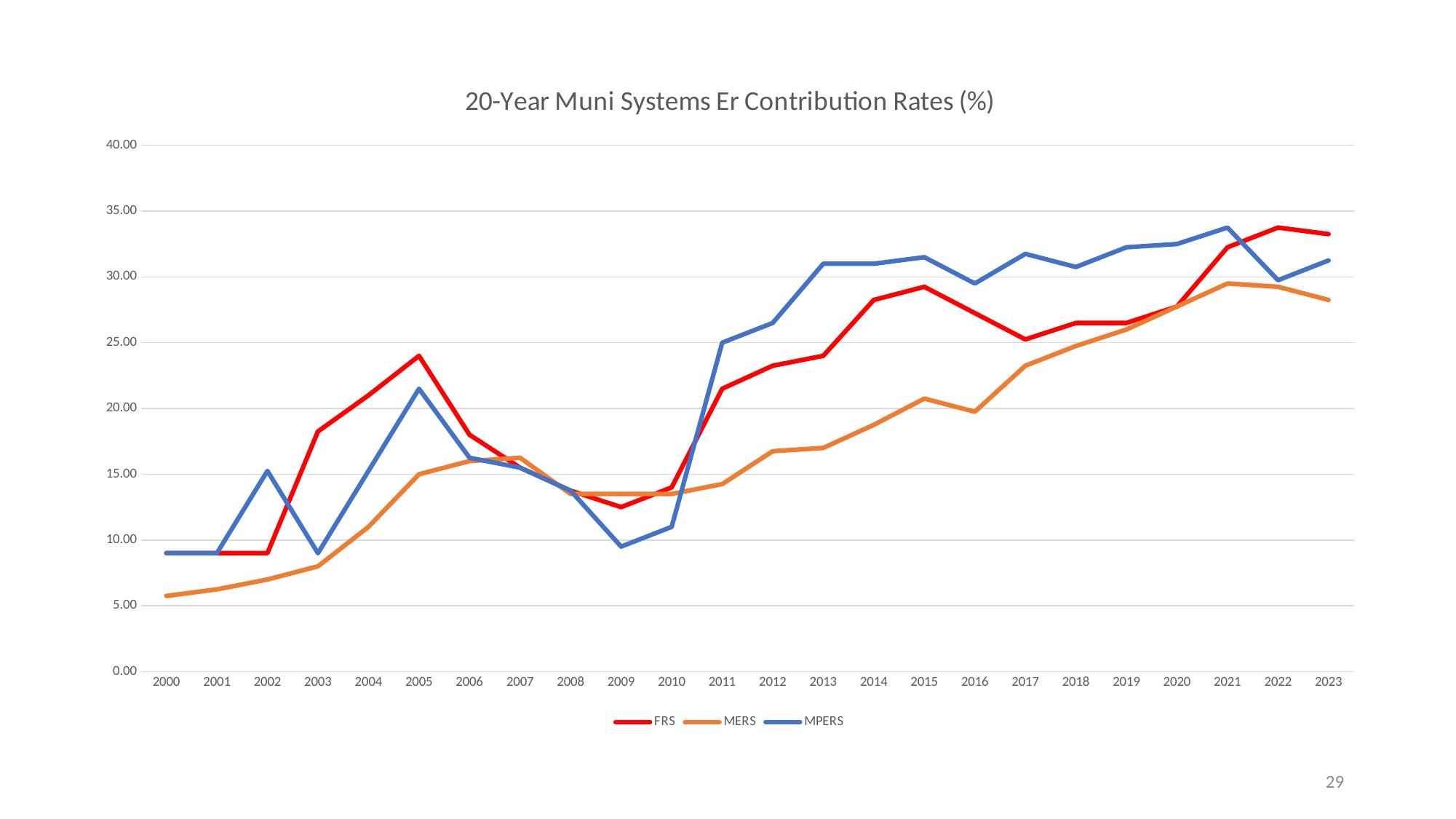
Is the value for MPERS in 2013 greater or less than 30.00? greater Which colour is used for the MPERS line? blue How many years are plotted along the x axis? 24 Does the MERS line generally rise or fall from 2000 to 2005? rise Is the value for FRS in 2005 greater or less than 20.00? greater How many series does the legend list? 3 In 2011, which series has the higher value, FRS or MPERS? MPERS What kind of chart is shown on the slide? line chart Is the value for MERS in 2012 greater or less than 15.00? greater What is the title of the chart? 20-Year Muni Systems Er Contribution Rates (%) In 2022, which series has the higher value, FRS or MPERS? FRS In which year does the MERS line reach its lowest value? 2000